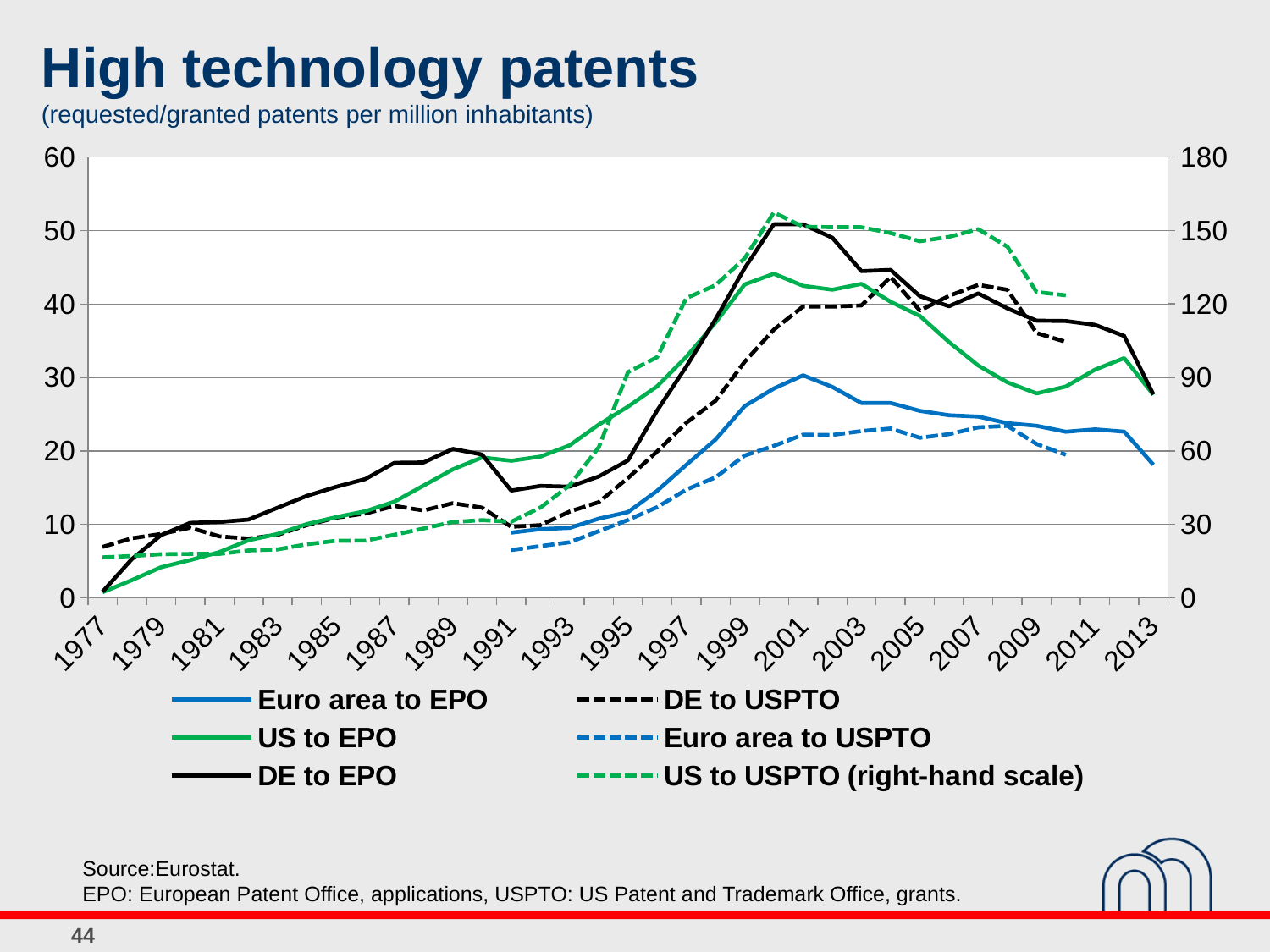
Which series is plotted on the right-hand scale? US to USPTO Which series has the highest value in 2000 among those on the left-hand scale? DE to EPO What kind of chart is shown on the slide? line chart How many series does the legend list? 6 Is the value for DE to EPO in 2000 greater or less than 40? greater Is the value for US to EPO in 2000 greater or less than 40? greater Does the Euro area to EPO series rise or fall between 1991 and 2001? rise Is the value for US to USPTO (right-hand scale) in 2000 greater or less than 150? greater What is the title of the chart? High technology patents In 2013, which is larger: DE to EPO or Euro area to EPO? DE to EPO